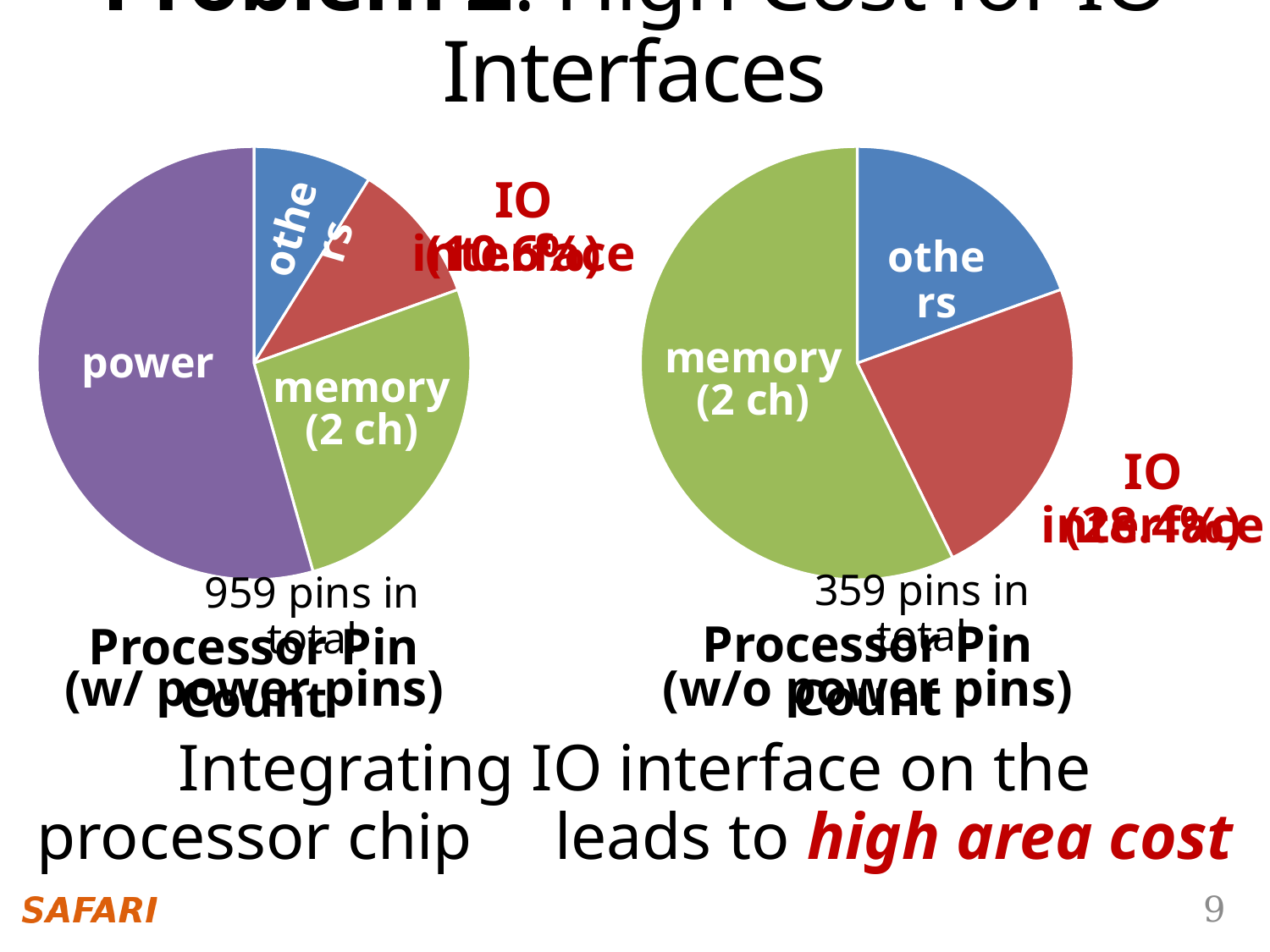
What kind of chart is the right chart, titled "Processor Pin Count (w/o power pins)"? pie chart In the right chart (w/o power pins), which category has the largest slice? memory (2 ch) In the left chart (w/ power pins), how many slices does the pie have? 4 What kind of chart is the left chart, titled "Processor Pin Count (w/ power pins)"? pie chart In the right chart (w/o power pins), which category has the smallest slice? others Which category appears in the left chart (w/ power pins) but not in the right chart (w/o power pins)? power In the left chart (w/ power pins), which category has the largest slice? power In the right chart (w/o power pins), how many slices does the pie have? 3 According to the left chart (w/ power pins), how many pins are there in total? 959 pins According to the right chart (w/o power pins), how many pins are there in total? 359 pins In the left chart (w/ power pins), which slice is larger: power or memory (2 ch)? power In the right chart (w/o power pins), which slice is larger: memory (2 ch) or others? memory (2 ch)